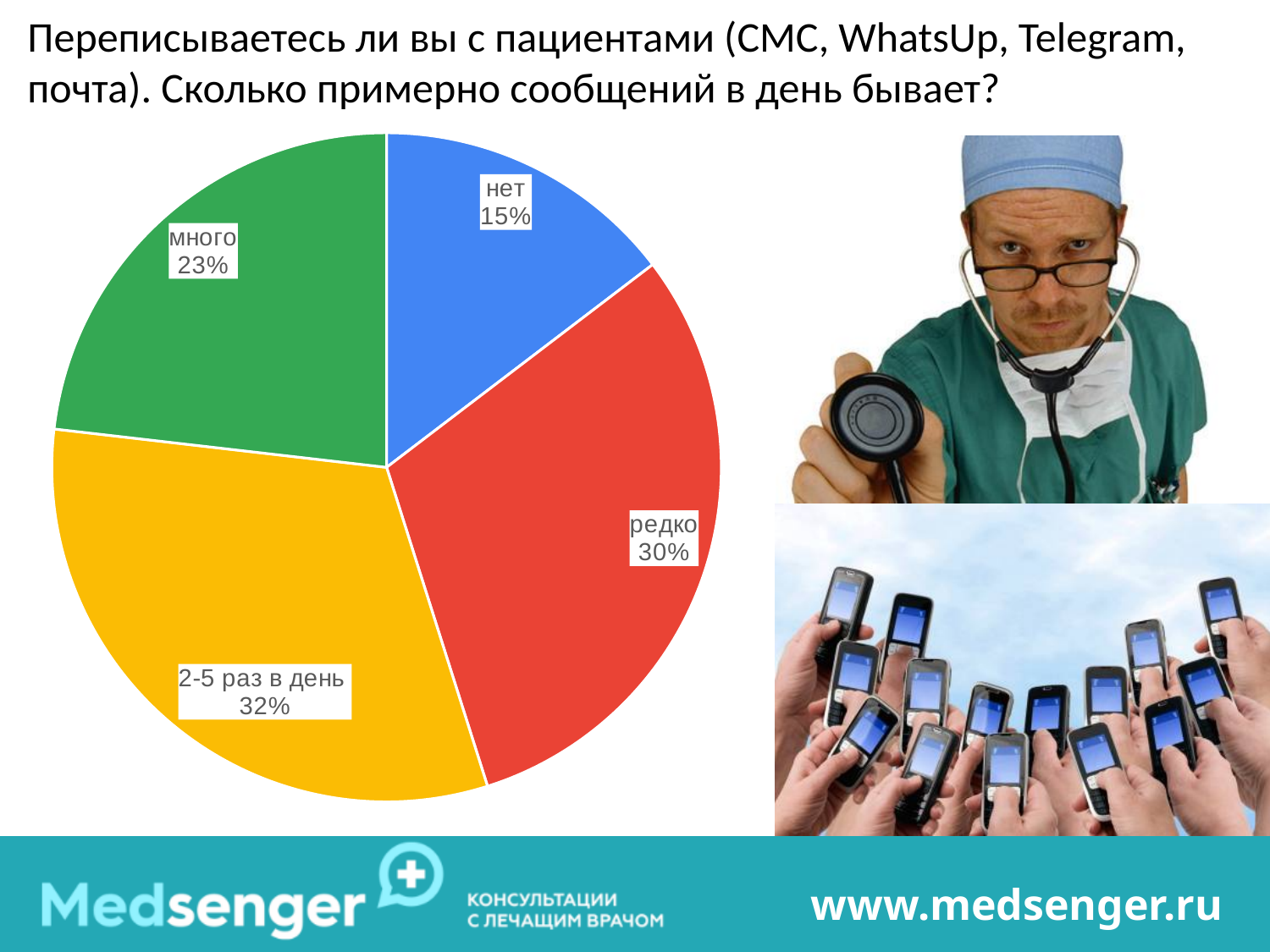
What share of the pie does the "много" slice represent? 23% What kind of chart is shown on the slide? pie chart What share of the pie does the "2-5 раз в день" slice represent? 32% Which slice is larger, "много" or "нет"? много How many categories are shown in the pie chart? 4 Which category has the smallest slice of the pie? нет Which category has the largest slice of the pie? 2-5 раз в день What share of the pie does the "редко" slice represent? 30% What is the difference in percentage points between the "2-5 раз в день" and "много" slices? 9 What colour is the "редко" slice of the pie? red What is the difference in percentage points between the "редко" and "нет" slices? 15